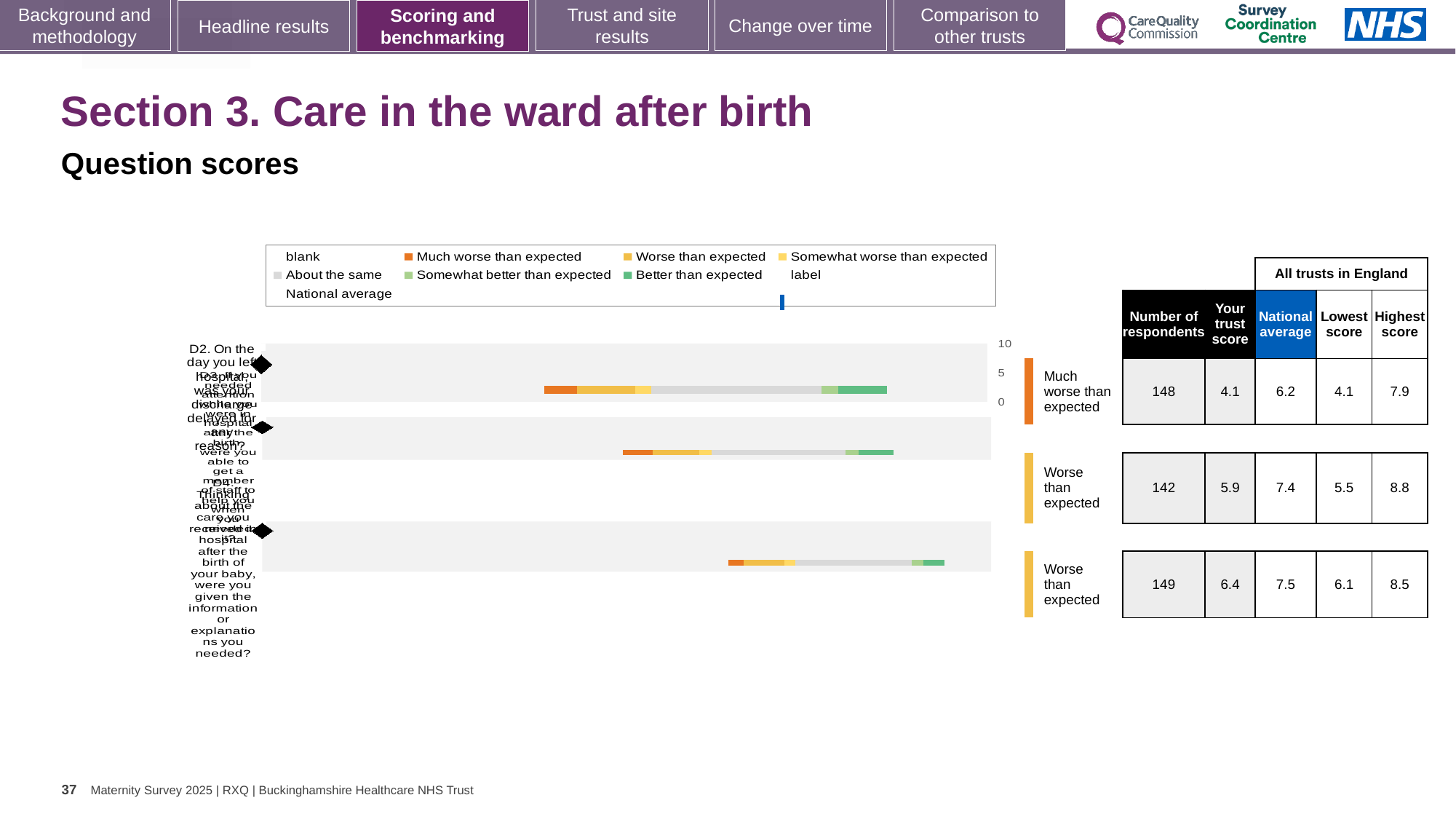
What colour represents 'Much worse than expected' in the chart legend? orange In the table beside the chart, for the first row, which is larger: the trust score or the national average? national average What kind of chart is shown on the slide? bar chart What colour represents 'Better than expected' in the chart legend? green In the table beside the chart, what is the difference between the national average and the trust score for the first row? 2.1 In the table beside the chart, what is the number of respondents for the first (top) row? 148 In the table beside the chart, what is 'Your trust score' for the first (top) row? 4.1 What is the highest tick value shown on the chart's numeric axis? 10 In the table beside the chart, what is the national average for the second row? 7.4 In the table beside the chart, which row has the highest number of respondents? the third (bottom) row, 149 How many stacked bars does the chart contain? 3 In the table beside the chart, what is the highest score for the third (bottom) row? 8.5